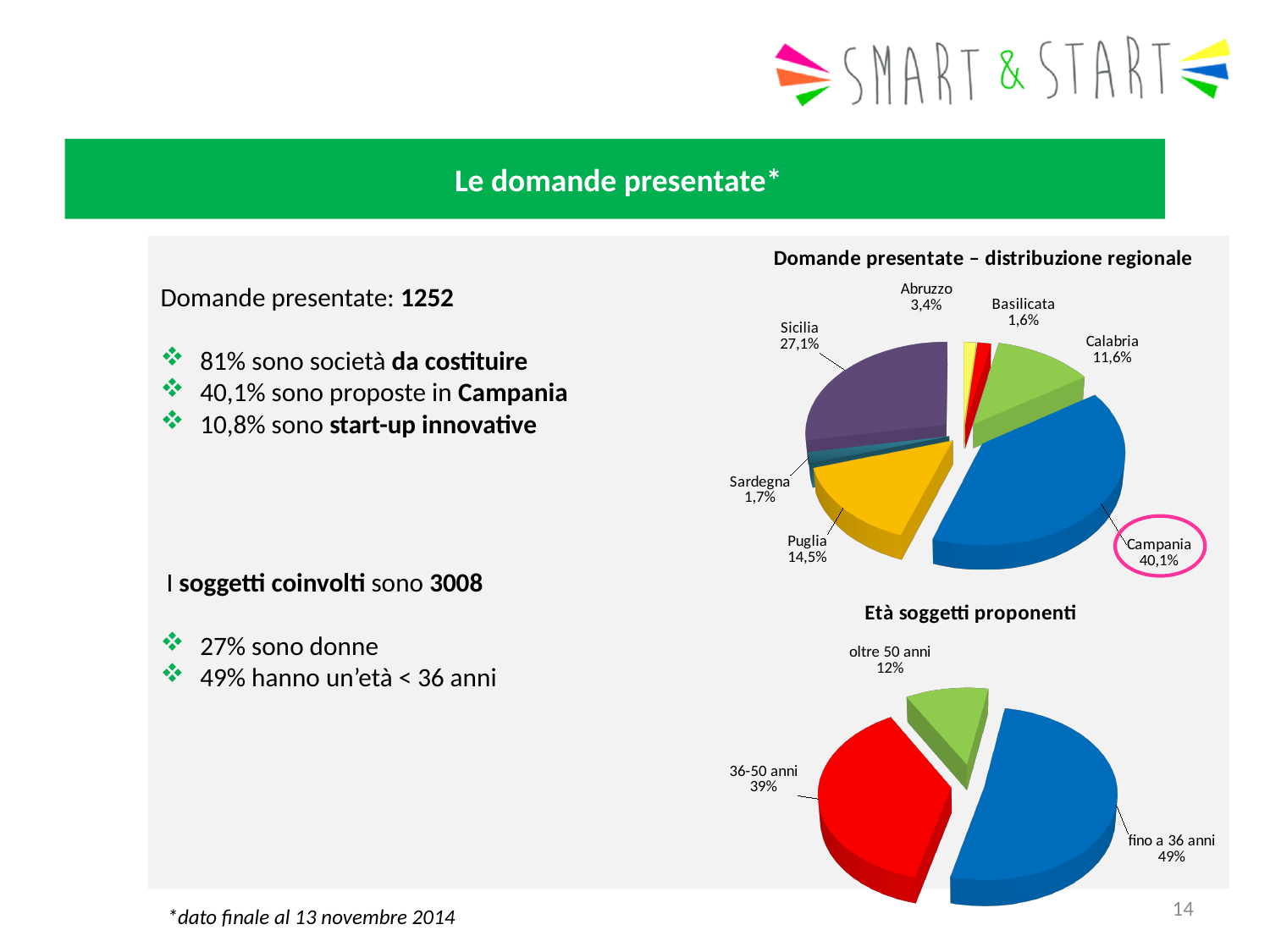
What type of chart is 'Domande presentate – distribuzione regionale'? Pie chart How many regions are shown in the 'Domande presentate – distribuzione regionale' chart? 7 In the 'Domande presentate – distribuzione regionale' chart, what share is shown for Puglia? 14,5% In the 'Domande presentate – distribuzione regionale' chart, which has a larger share, Calabria or Puglia? Puglia How many age groups are shown in the 'Età soggetti proponenti' chart? 3 In the 'Domande presentate – distribuzione regionale' chart, which region has the largest share? Campania In the 'Domande presentate – distribuzione regionale' chart, which region has the smallest share? Basilicata In the 'Domande presentate – distribuzione regionale' chart, what share is shown for Sicilia? 27,1% In the 'Domande presentate – distribuzione regionale' chart, what share is shown for Campania? 40,1% In the 'Domande presentate – distribuzione regionale' chart, what is the difference in percentage points between Campania and Sicilia? 13 percentage points In the 'Età soggetti proponenti' chart, which age group has the largest share? fino a 36 anni In the 'Età soggetti proponenti' chart, what share is shown for '36-50 anni'? 39%